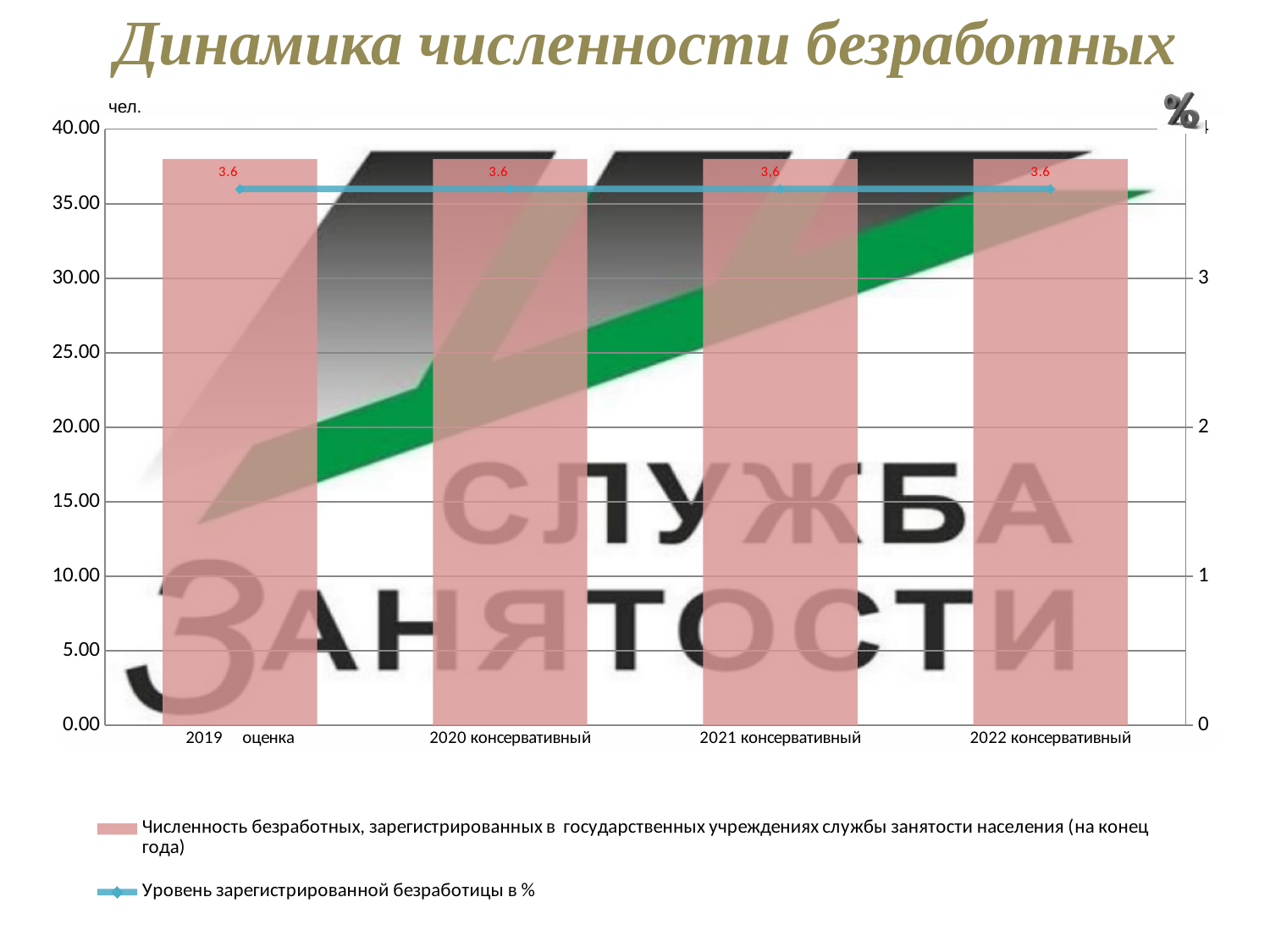
Does the registered unemployment rate line rise, fall, or stay flat from 2019 оценка to 2022 консервативный? Stays flat What kind of chart is shown on the slide? Combined bar and line chart Is the number of registered unemployed (bar) for 2019 оценка greater or less than 40.00? less What is the value of the registered unemployment rate line for 2021 консервативный? 3.6 How many categories are shown on the x axis of the chart? 4 How many series does the legend list? 2 Is the number of registered unemployed (bar) for 2020 консервативный greater or less than 35.00? greater What unit is shown at the top of the left vertical axis? чел. What is the title of the chart on the slide? Динамика численности безработных What is the value of the registered unemployment rate (Уровень зарегистрированной безработицы в %) for 2019 оценка? 3.6 What is the difference between the unemployment rate values for 2019 оценка and 2020 консервативный? 0 What is the value of the registered unemployment rate (Уровень зарегистрированной безработицы в %) for 2022 консервативный? 3.6